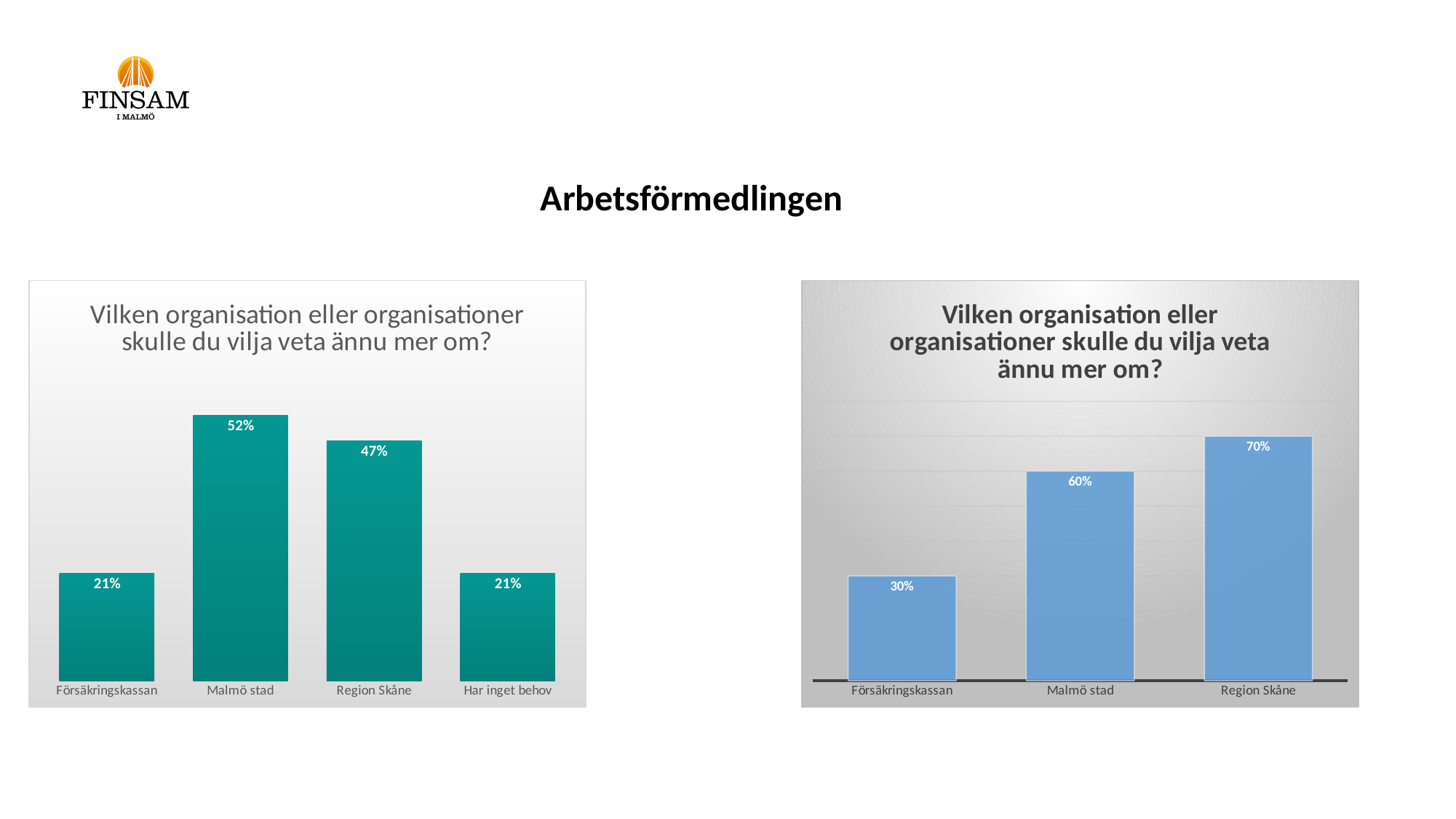
In the left chart, what is the value for Malmö stad? 52% In the right chart, what is the value for Försäkringskassan? 30% In the right chart, do the values rise or fall from left to right along the x axis? rise In the right chart, which category has the lowest value? Försäkringskassan In the left chart, what is the value for Har inget behov? 21% In the right chart, what is the difference between Region Skåne and Malmö stad? 10% In the left chart, how many categories are shown? 4 In the left chart, what is the difference between Malmö stad and Region Skåne? 5% In the left chart, what is the value for Region Skåne? 47% In the right chart, what is the value for Region Skåne? 70% In the left chart, which category has the highest value? Malmö stad What kind of chart is the right chart? bar chart